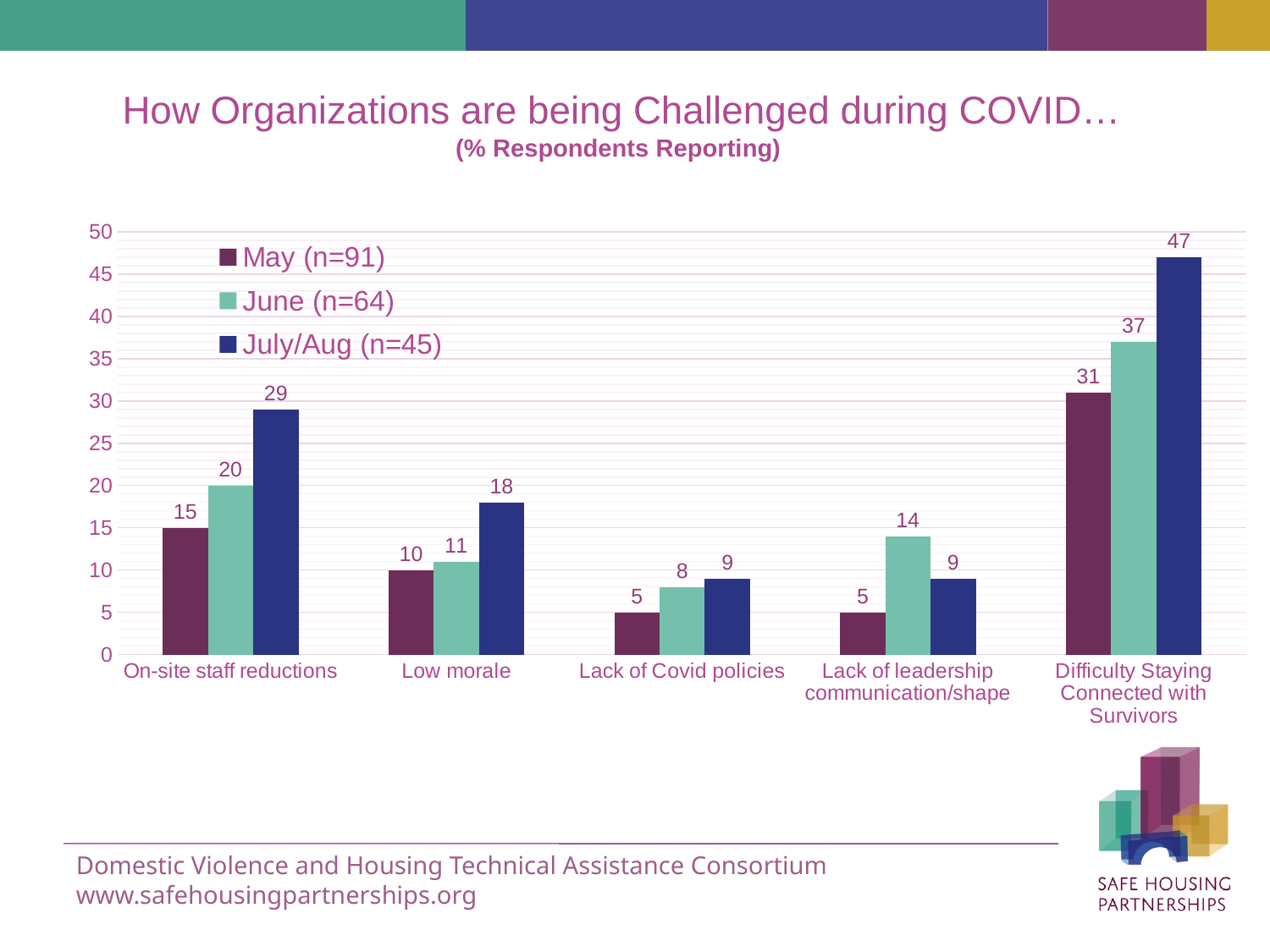
What kind of chart is shown on the slide? Bar chart What is the May (n=91) value for On-site staff reductions? 15 What is the difference between the July/Aug (n=45) and May (n=91) values for On-site staff reductions? 14 What is the July/Aug (n=45) value for Difficulty Staying Connected with Survivors? 47 Which is larger for Low morale: the June (n=64) value or the July/Aug (n=45) value? July/Aug (n=45) How many categories are shown on the x axis? 5 What is the June (n=64) value for Lack of leadership communication/shape? 14 What is the subtitle shown under the chart title? (% Respondents Reporting) How many series does the legend list? 3 Which category has the lowest May (n=91) value? Lack of Covid policies and Lack of leadership communication/shape (both 5) Do the values for Difficulty Staying Connected with Survivors rise or fall from May to July/Aug? Rise Which category has the highest July/Aug (n=45) value? Difficulty Staying Connected with Survivors